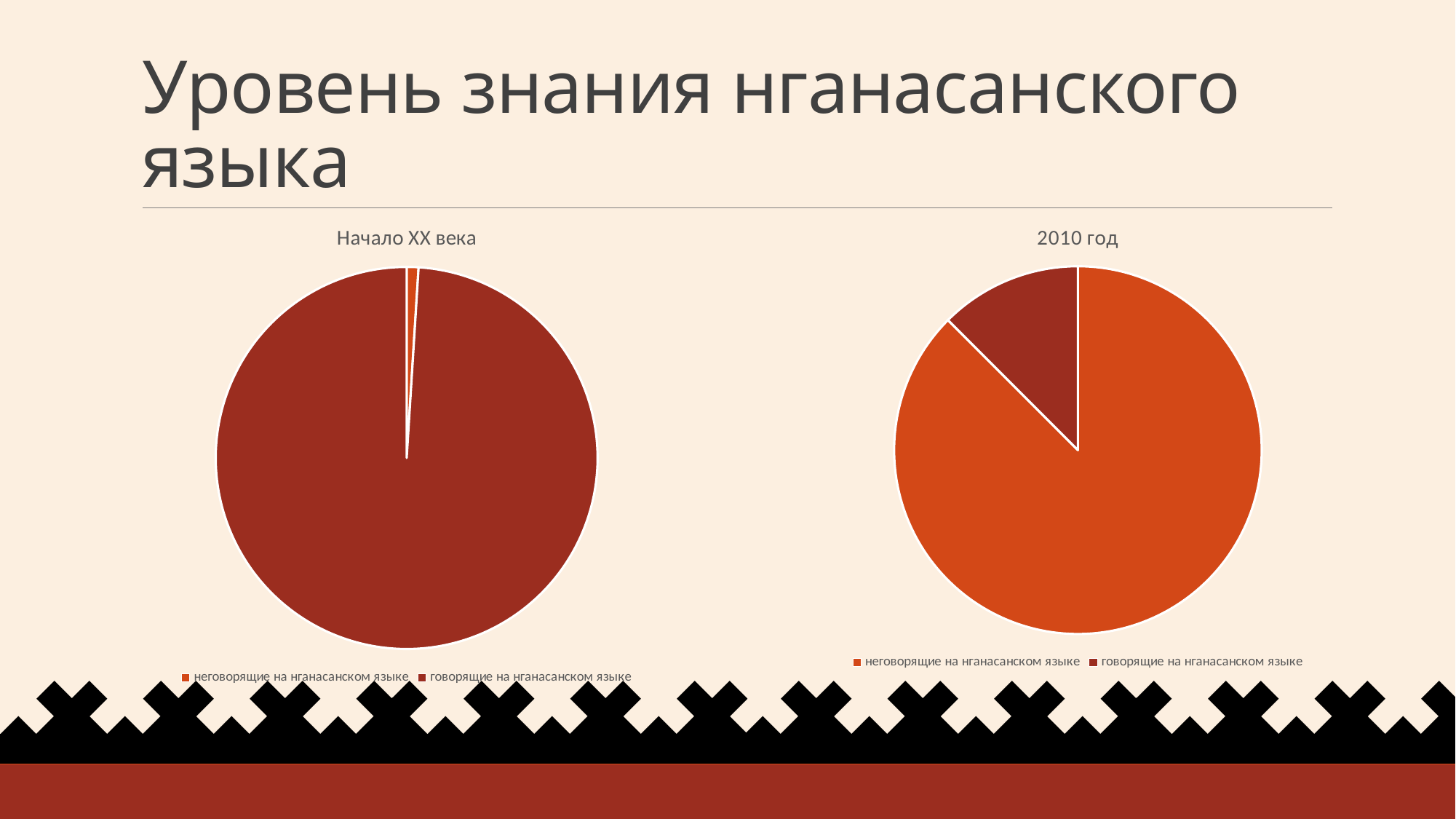
In the "2010 год" chart, which slice is larger: "говорящие на нганасанском языке" or "неговорящие на нганасанском языке"? неговорящие на нганасанском языке In the "2010 год" chart, which category has the largest slice? неговорящие на нганасанском языке What is the title of the chart on the right of the slide? 2010 год How many entries does the legend of the "Начало XX века" chart list? 2 What is the title of the chart on the left of the slide? Начало XX века In the "Начало XX века" chart, which category has the largest slice? говорящие на нганасанском языке In the "Начало XX века" chart, which slice is larger: "говорящие на нганасанском языке" or "неговорящие на нганасанском языке"? говорящие на нганасанском языке What kind of chart is used for "Начало XX века"? pie chart What kind of chart is used for "2010 год"? pie chart How many slices does the "2010 год" pie chart have? 2 In the "2010 год" chart, which category has the smallest slice? говорящие на нганасанском языке In the "Начало XX века" chart, which category has the smallest slice? неговорящие на нганасанском языке